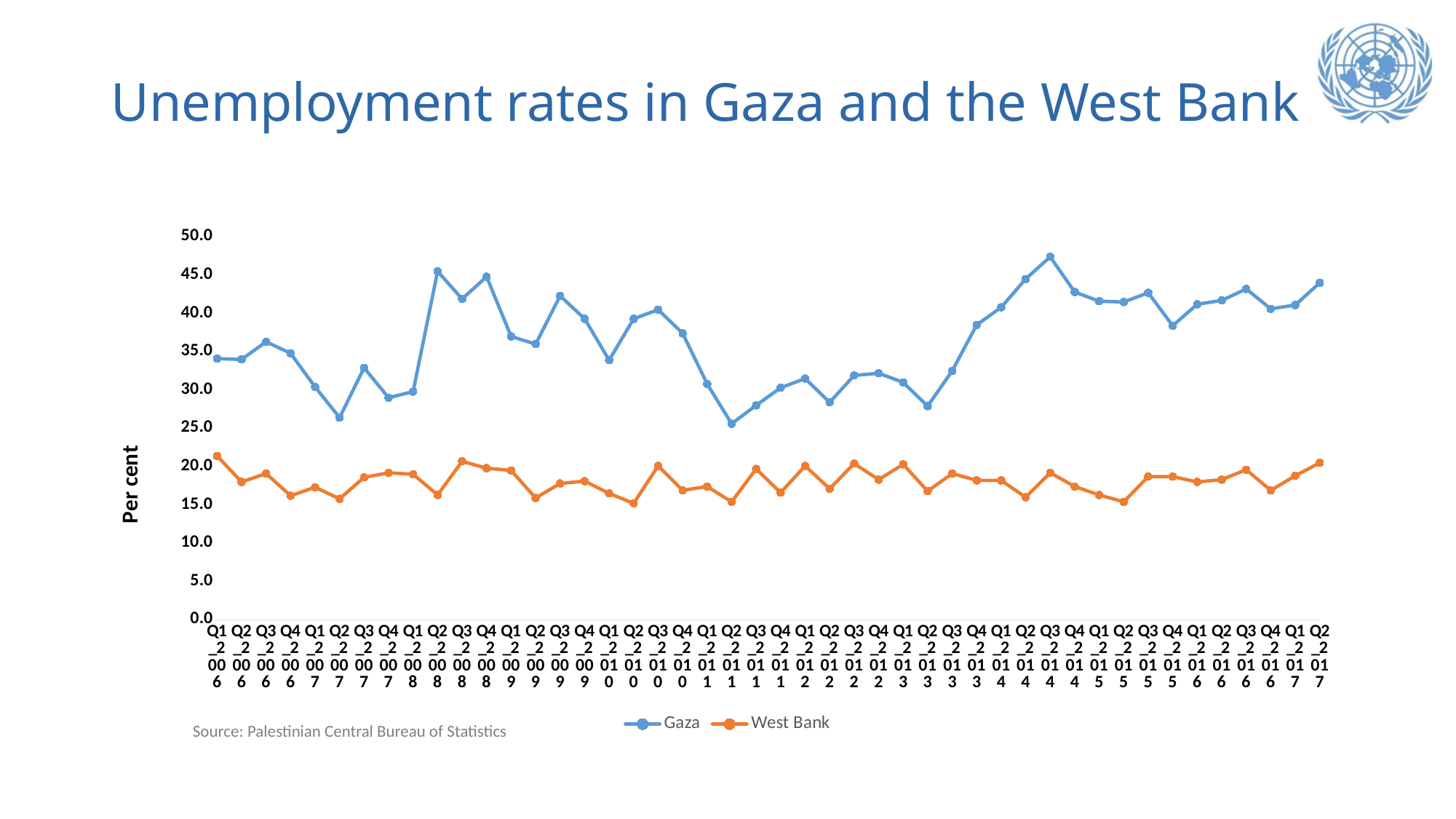
In which quarter does the Gaza series reach its highest value? Q3_2014 Which series has the larger value in Q2_2017, Gaza or West Bank? Gaza Which two series are shown in the legend? Gaza and West Bank Is the West Bank value for Q2_2010 greater or less than 20? less Is the Gaza value for Q2_2011 greater or less than 30? less Is the Gaza value for Q3_2014 greater or less than 45? greater What kind of chart is shown on the slide? line chart How many series does the legend list? 2 How many quarterly data points are plotted for each series? 46 What is the label on the vertical axis? Per cent Does the Gaza series rise or fall between Q2_2013 and Q3_2014? rise